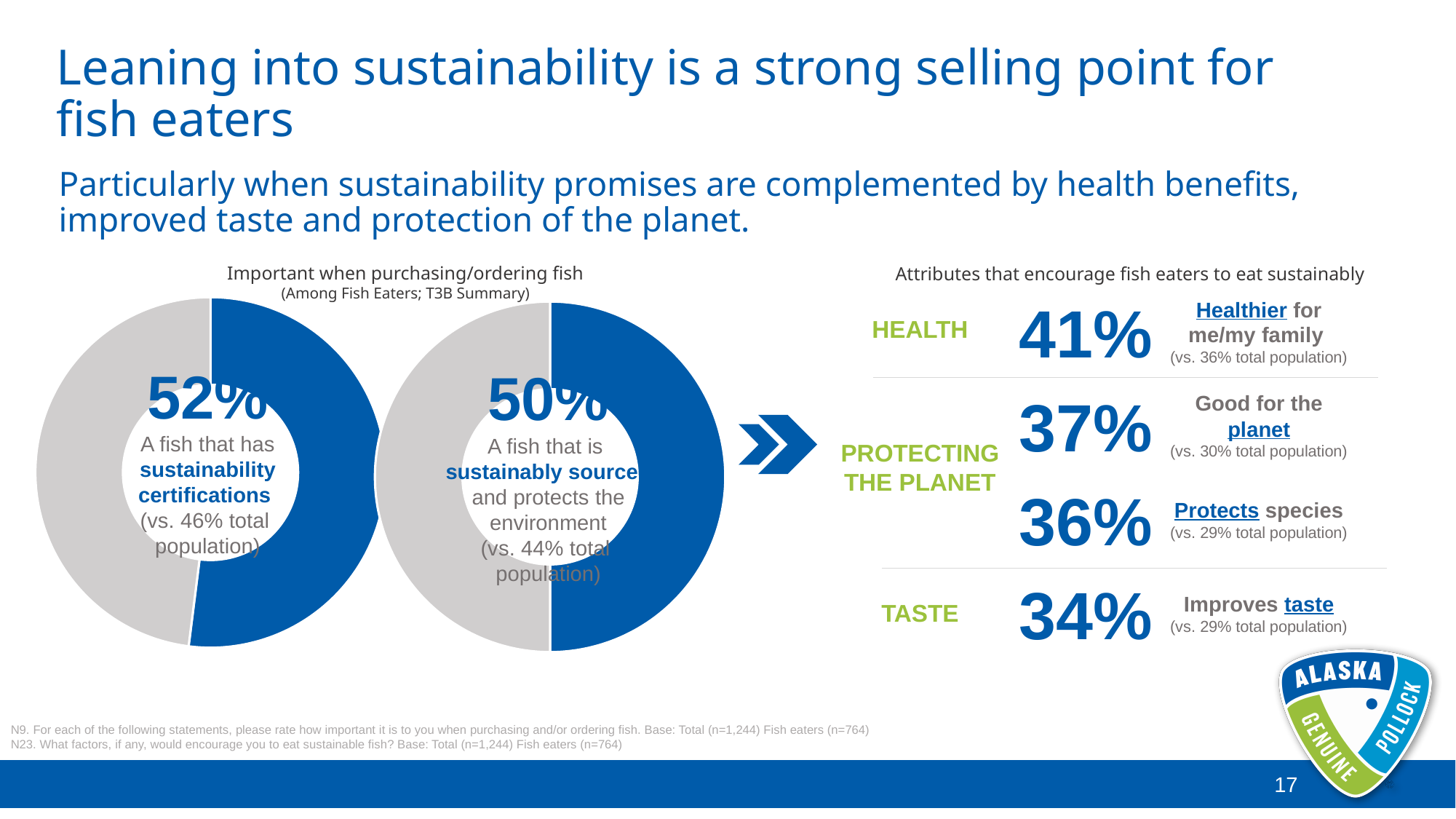
What kind of chart is used on the left side of the slide to show the percentages 52% and 50%? Pie chart (donut) According to the right donut chart, what is the total population figure given for comparison with the 50% for sustainably sourced fish? 44% In the left donut chart, what percentage of fish eaters say a fish that has sustainability certifications is important when purchasing/ordering fish? 52% In the right donut chart, what percentage of fish eaters say a fish that is sustainably sourced and protects the environment is important? 50% In the left donut chart, how many percentage points higher is the fish eaters' figure (52%) than the total population figure (46%)? 6 percentage points According to the left donut chart, what is the total population figure given for comparison with the 52% for sustainability certifications? 46% How many donut charts are shown on the slide? 2 In the left donut chart, what share of the ring is filled in blue? 52% What colour is used for the highlighted segment in the donut charts? Blue What is the title above the two donut charts? Important when purchasing/ordering fish (Among Fish Eaters; T3B Summary) What is the difference in percentage points between the left donut chart (52%) and the right donut chart (50%)? 2 percentage points Which donut chart shows the higher percentage: sustainability certifications or sustainably sourced and protects the environment? Sustainability certifications (52%)